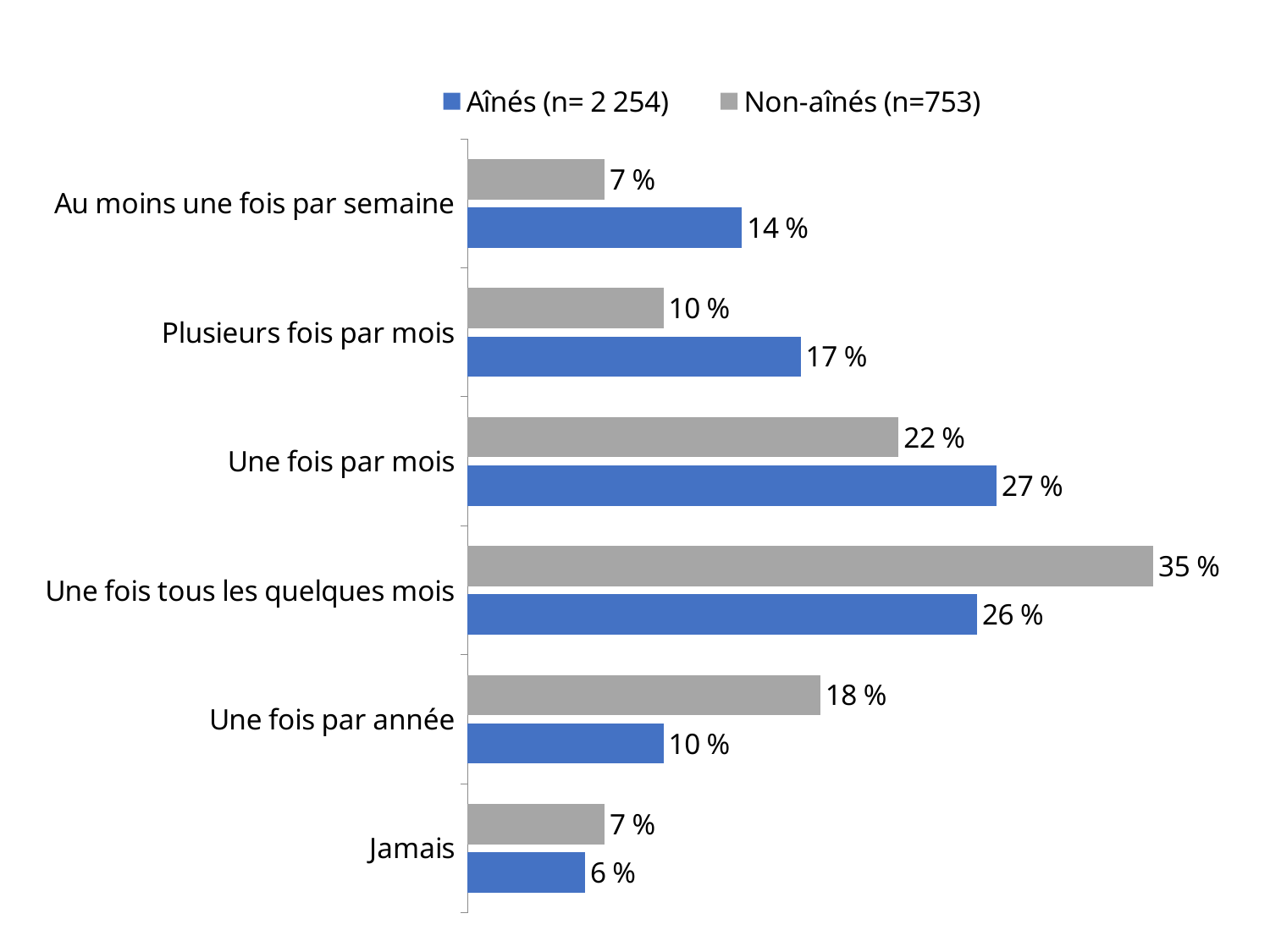
What is the value for Aînés for "Au moins une fois par semaine"? 14 % Which category has the highest value for Non-aînés? Une fois tous les quelques mois What is the value for Aînés for "Une fois par mois"? 27 % For "Plusieurs fois par mois", which series has the larger value, Aînés or Non-aînés? Aînés Which category has the lowest value for Aînés? Jamais What is the sample size (n) shown in the legend for Non-aînés? 753 What kind of chart is shown on the slide? Bar chart How many categories are shown on the chart? 6 How many series does the legend list? 2 What is the value for Non-aînés for "Une fois tous les quelques mois"? 35 % What is the difference between the Non-aînés and Aînés values for "Une fois par année"? 8 % Which colour represents the Aînés series? Blue